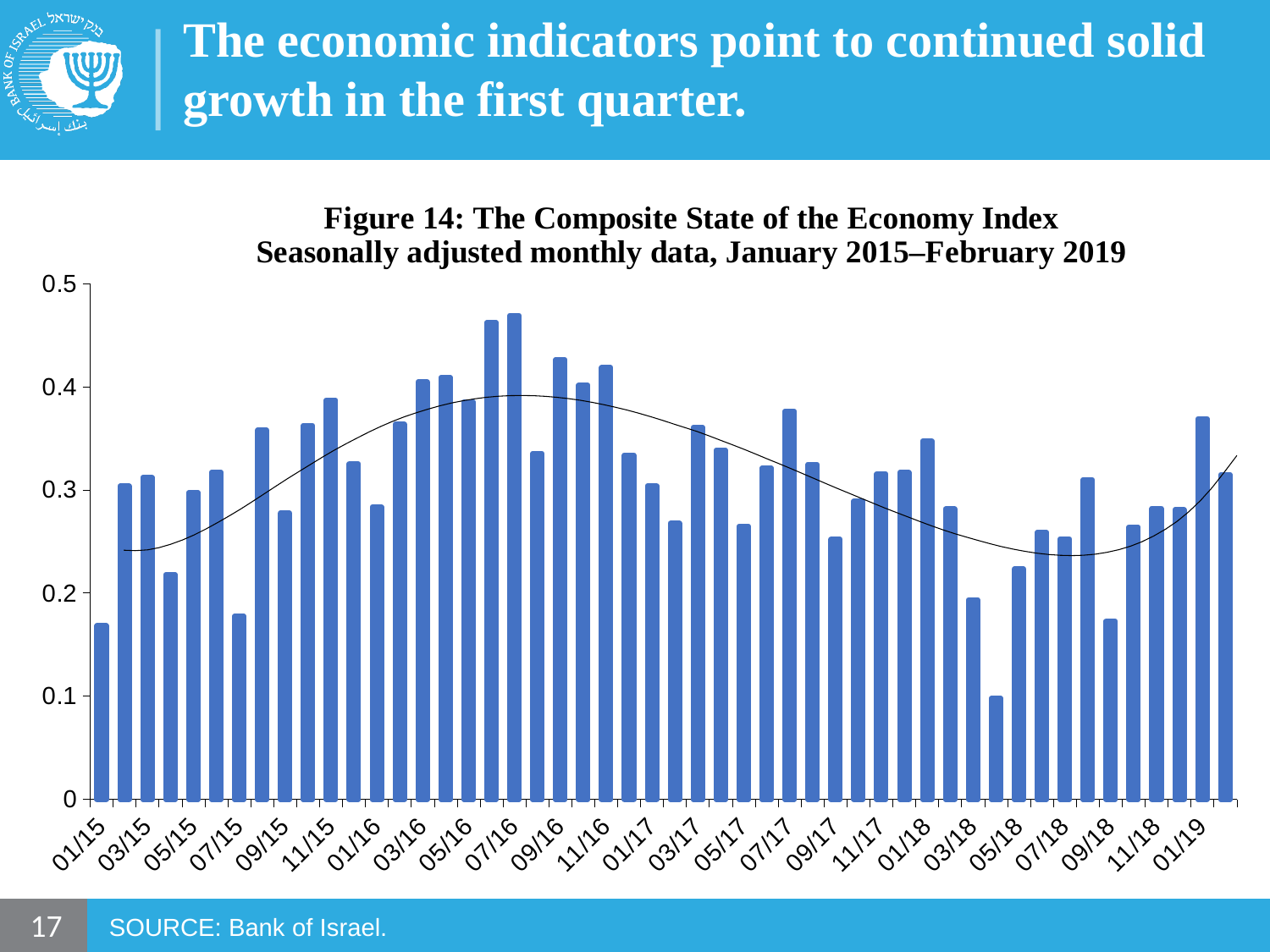
Is the value for 01/19 greater or less than 0.3? greater Is the value for 01/18 greater or less than 0.3? greater What is the highest value shown on the vertical axis? 0.5 Which is larger, the value for 07/16 or the value for 07/18? 07/16 What kind of chart is shown in Figure 14? bar chart Is the value for 01/15 greater or less than 0.2? less Between 01/15 and 07/16, do the bars generally rise or fall? rise What is the source given for the chart? Bank of Israel Which is larger, the value for 01/15 or the value for 01/19? 01/19